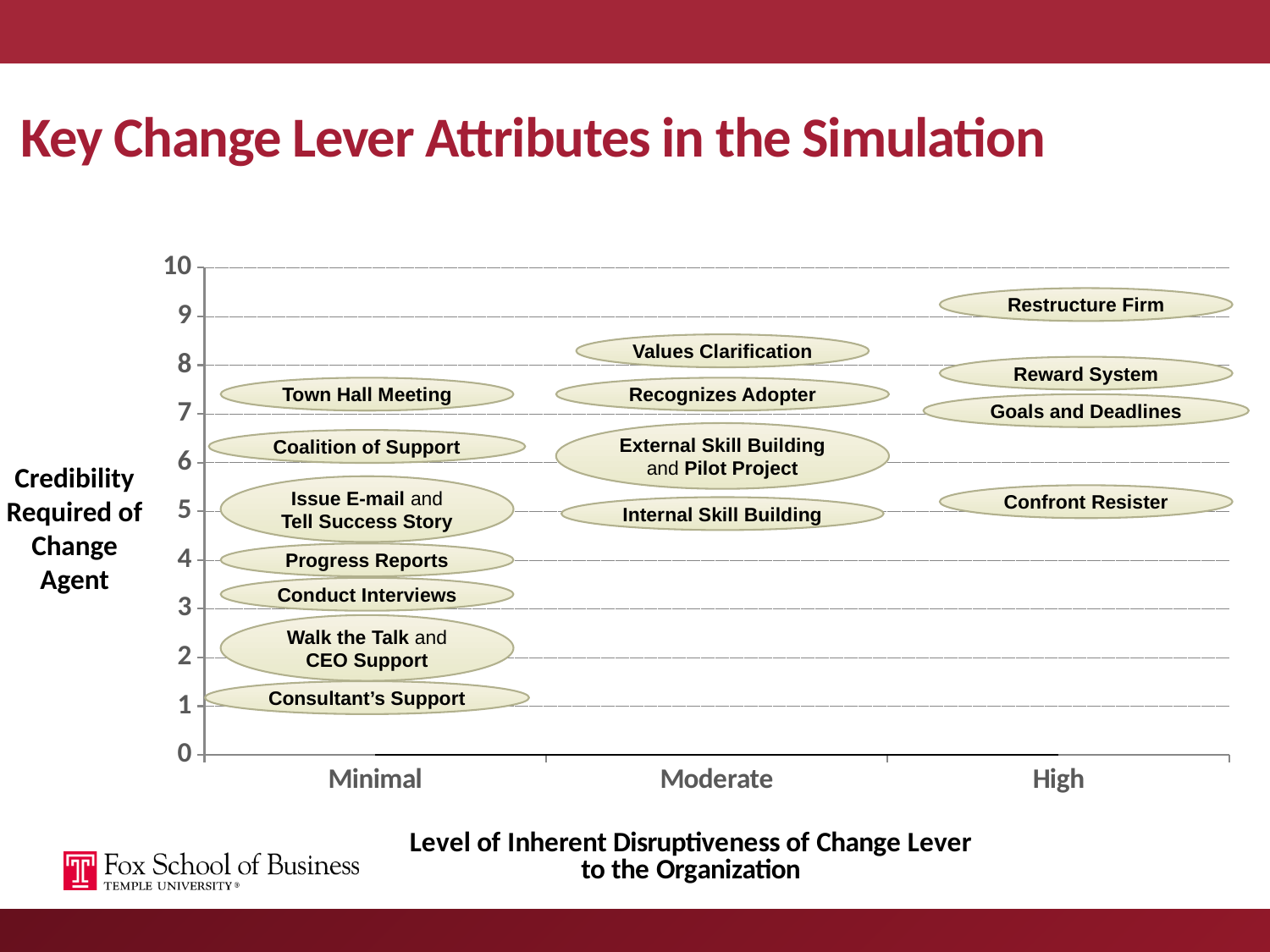
Which change lever is plotted lowest on the Credibility Required of Change Agent axis? Consultant's Support How many change levers are plotted in the High disruptiveness column? 4 What are the three categories shown on the x axis of the chart? Minimal, Moderate, High Is the credibility value for Values Clarification greater or less than 7? greater Is the credibility value for Restructure Firm greater or less than 8? greater Which requires more credibility of the change agent, Town Hall Meeting or Coalition of Support? Town Hall Meeting Which change lever is plotted highest on the Credibility Required of Change Agent axis? Restructure Firm Is the credibility value for Confront Resister greater or less than 6? less Which requires more credibility of the change agent, Restructure Firm or Reward System? Restructure Firm